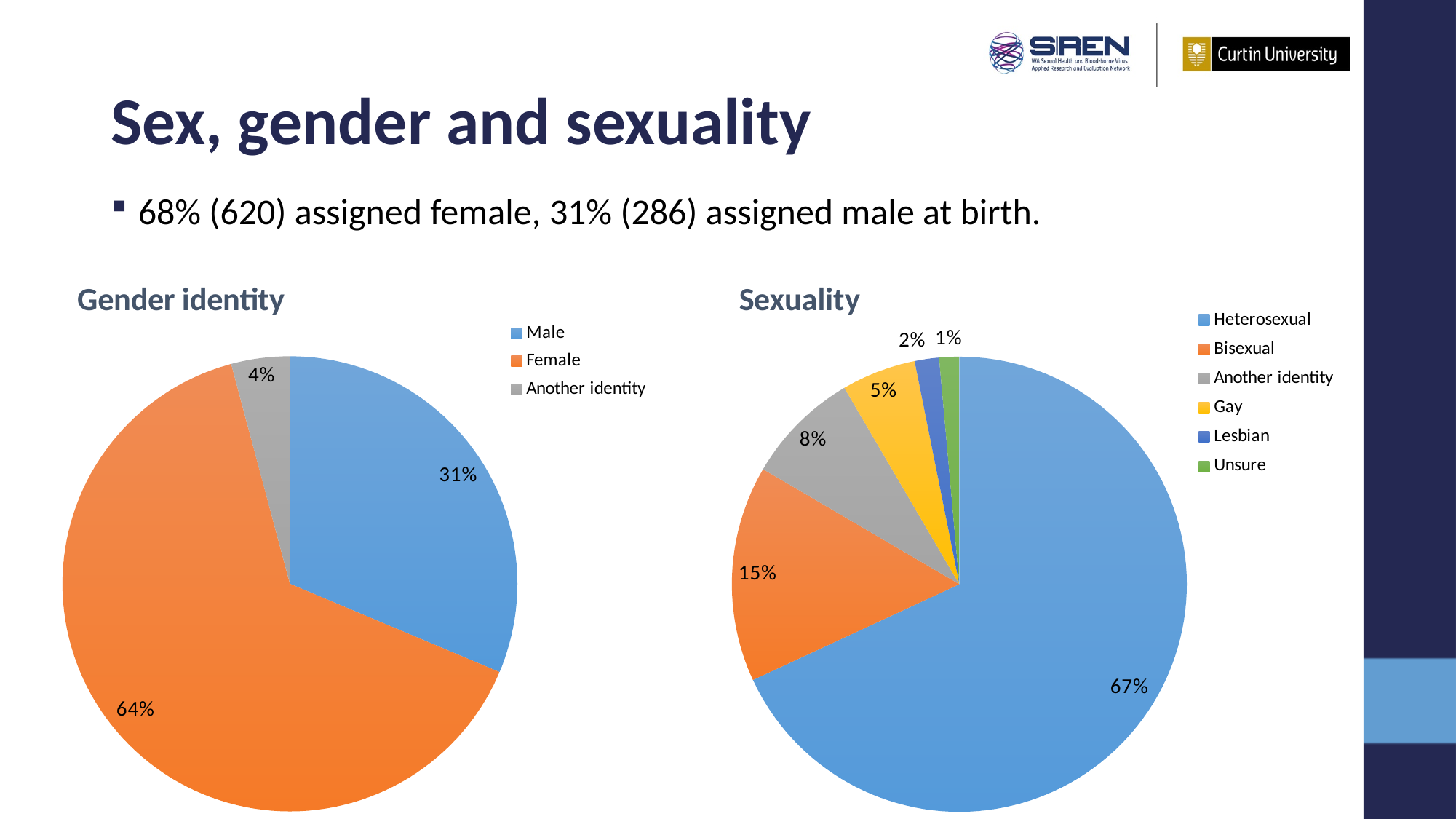
In the Sexuality chart, which category has the smallest share? Unsure What kind of chart is the Sexuality chart? Pie chart In the Gender identity chart, what percentage is Female? 64% In the Sexuality chart, which is larger, Another identity or Lesbian? Another identity In the Sexuality chart, what percentage is Bisexual? 15% In the Gender identity chart, which category has the smallest share? Another identity In the Sexuality chart, which category has the largest share? Heterosexual How many categories does the legend of the Sexuality chart list? 6 In the Gender identity chart, what percentage is Male? 31% In the Gender identity chart, what colour is the Female slice? Orange In the Sexuality chart, what percentage is Gay? 5% In the Gender identity chart, what is the difference in percentage points between Female and Male? 33